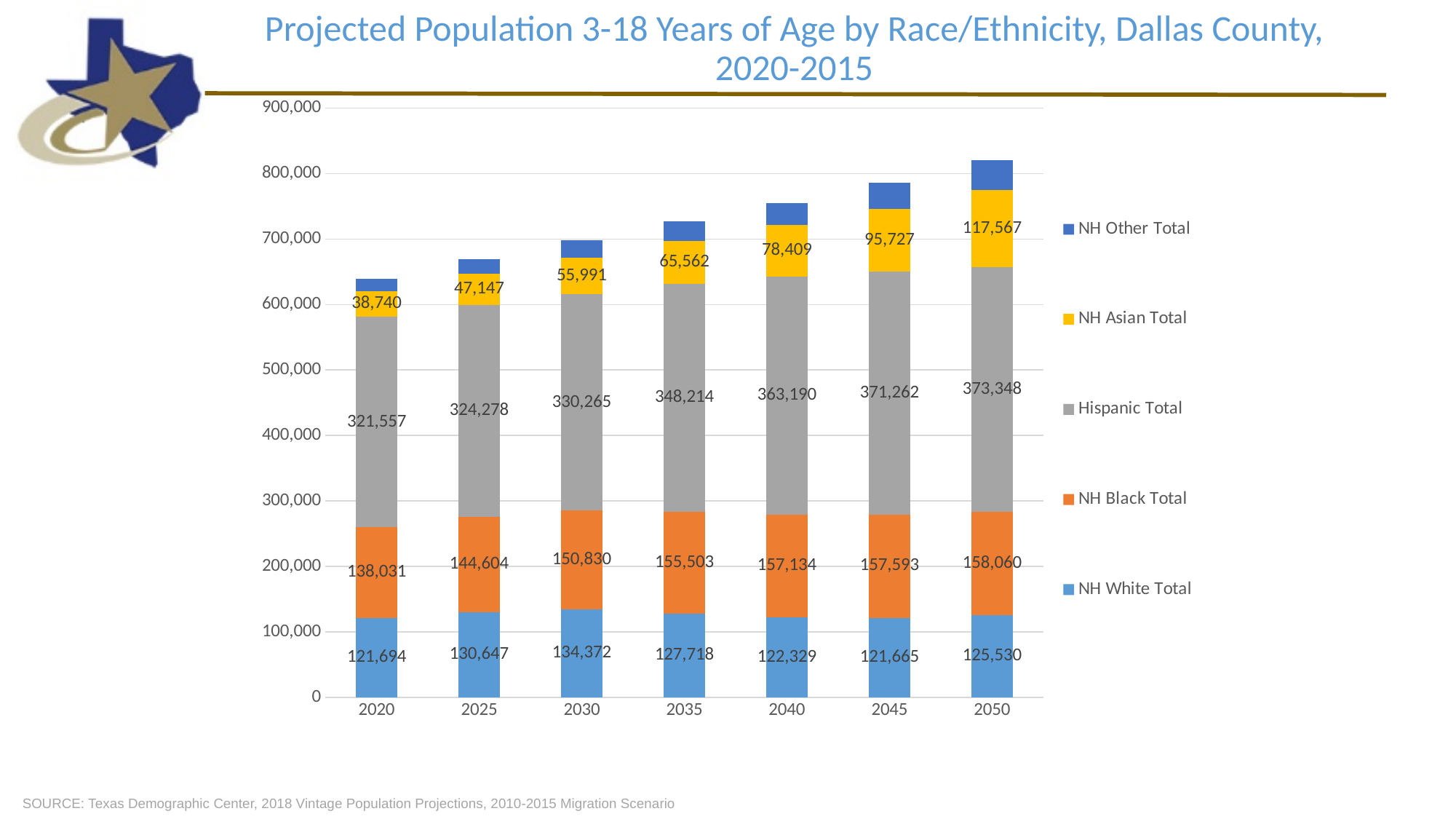
How many years are shown on the x axis? 7 What is the Hispanic Total value for 2020? 321,557 Which is larger in 2040, the NH Black Total or the NH White Total? NH Black Total How much larger is the NH Asian Total in 2050 than in 2020? 78,827 What is the NH Black Total value for 2045? 157,593 What is the NH Asian Total value for 2050? 117,567 Is the total height of the stacked bar for 2050 greater or less than 800,000? greater How many series does the legend list? 5 Does the Hispanic Total rise or fall from 2020 to 2050? rise In which year is the NH Asian Total lowest? 2020 What is the NH White Total value for 2030? 134,372 In which year is the Hispanic Total highest? 2050